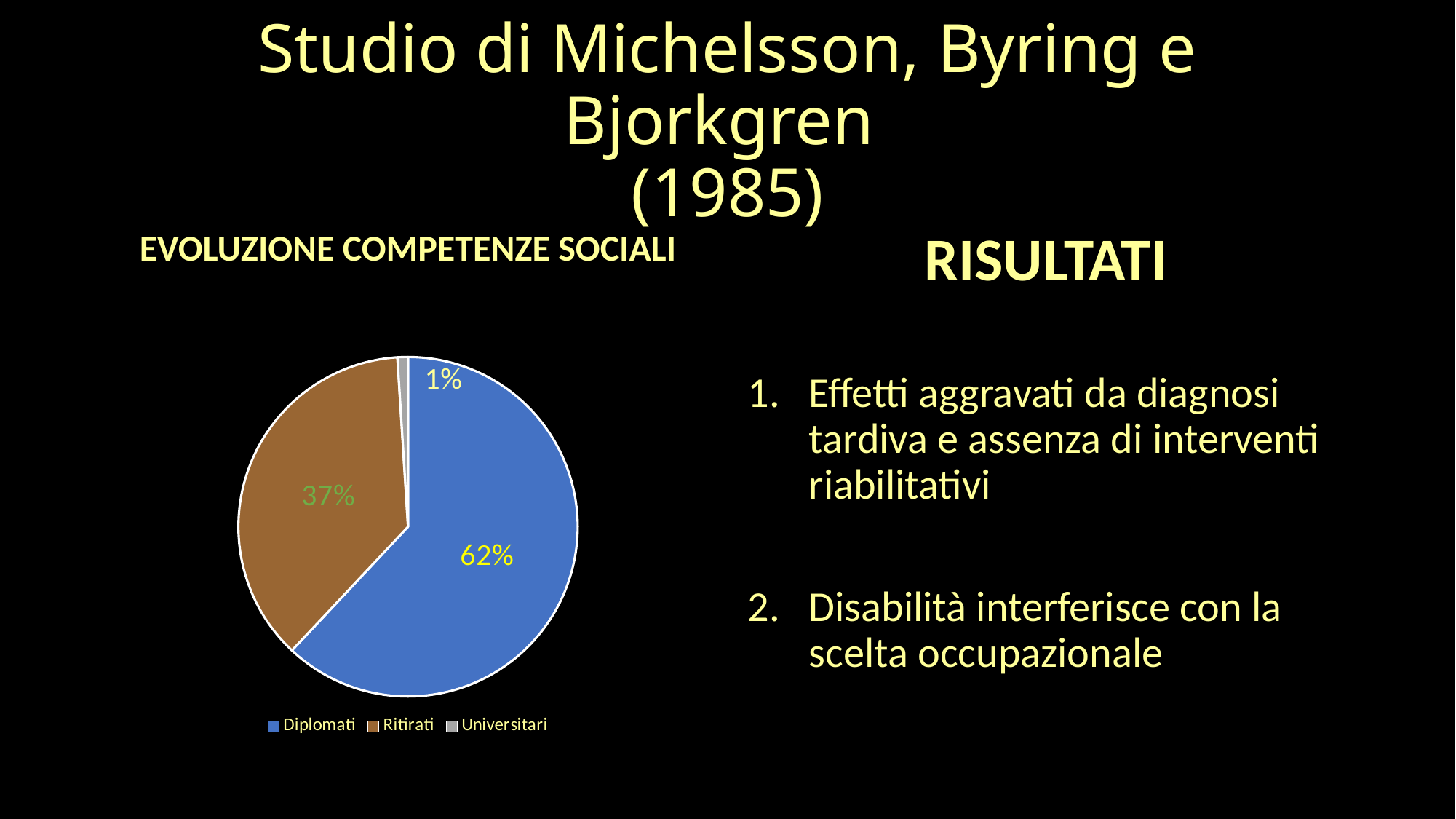
What kind of chart is shown on the slide? pie chart Which is larger, the share for Ritirati or the share for Universitari? Ritirati What share of the pie does Diplomati represent? 62% Which category has the largest slice of the pie? Diplomati What is the difference in percentage points between Diplomati and Ritirati? 25 How many categories does the pie chart show? 3 What share of the pie does Universitari represent? 1% What is the title of the chart? EVOLUZIONE COMPETENZE SOCIALI What is the difference in percentage points between Ritirati and Universitari? 36 What share of the pie does Ritirati represent? 37% Which category has the smallest slice of the pie? Universitari What colour is the Ritirati slice? brown